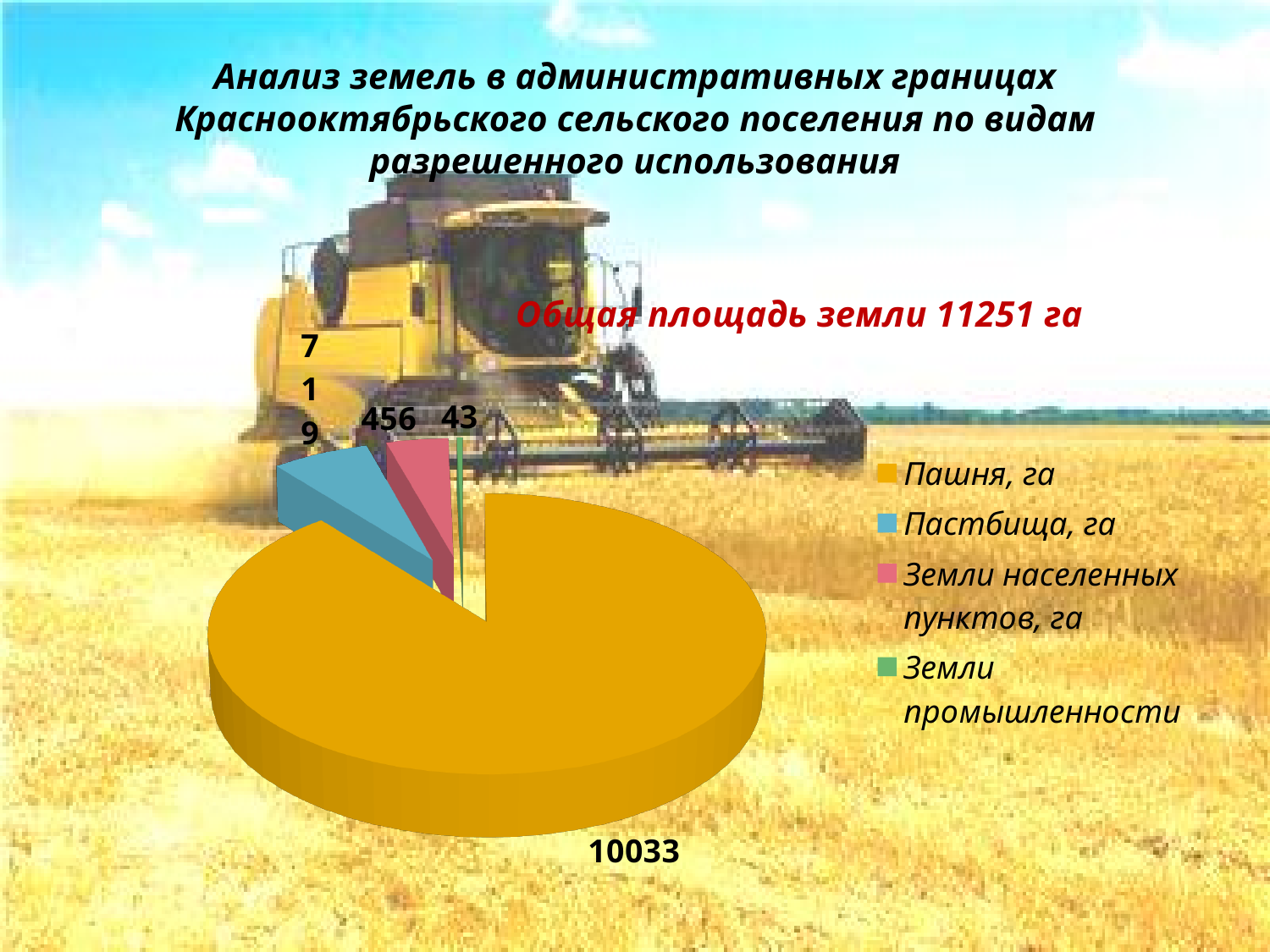
What is the value for Пашня, га? 10033 How many categories does the pie chart have? 4 Which category has the largest slice of the pie? Пашня, га What is the difference between the values for Пастбища, га and Земли населенных пунктов, га? 263 Which is larger, the value for Земли населенных пунктов, га or the value for Земли промышленности? Земли населенных пунктов, га What is the difference between the values for Пашня, га and Пастбища, га? 9314 What kind of chart is shown on the slide? pie chart What total land area is stated on the slide? 11251 га What is the value for Пастбища, га? 719 What is the value for Земли населенных пунктов, га? 456 What is the value for Земли промышленности? 43 Which category has the smallest slice of the pie? Земли промышленности